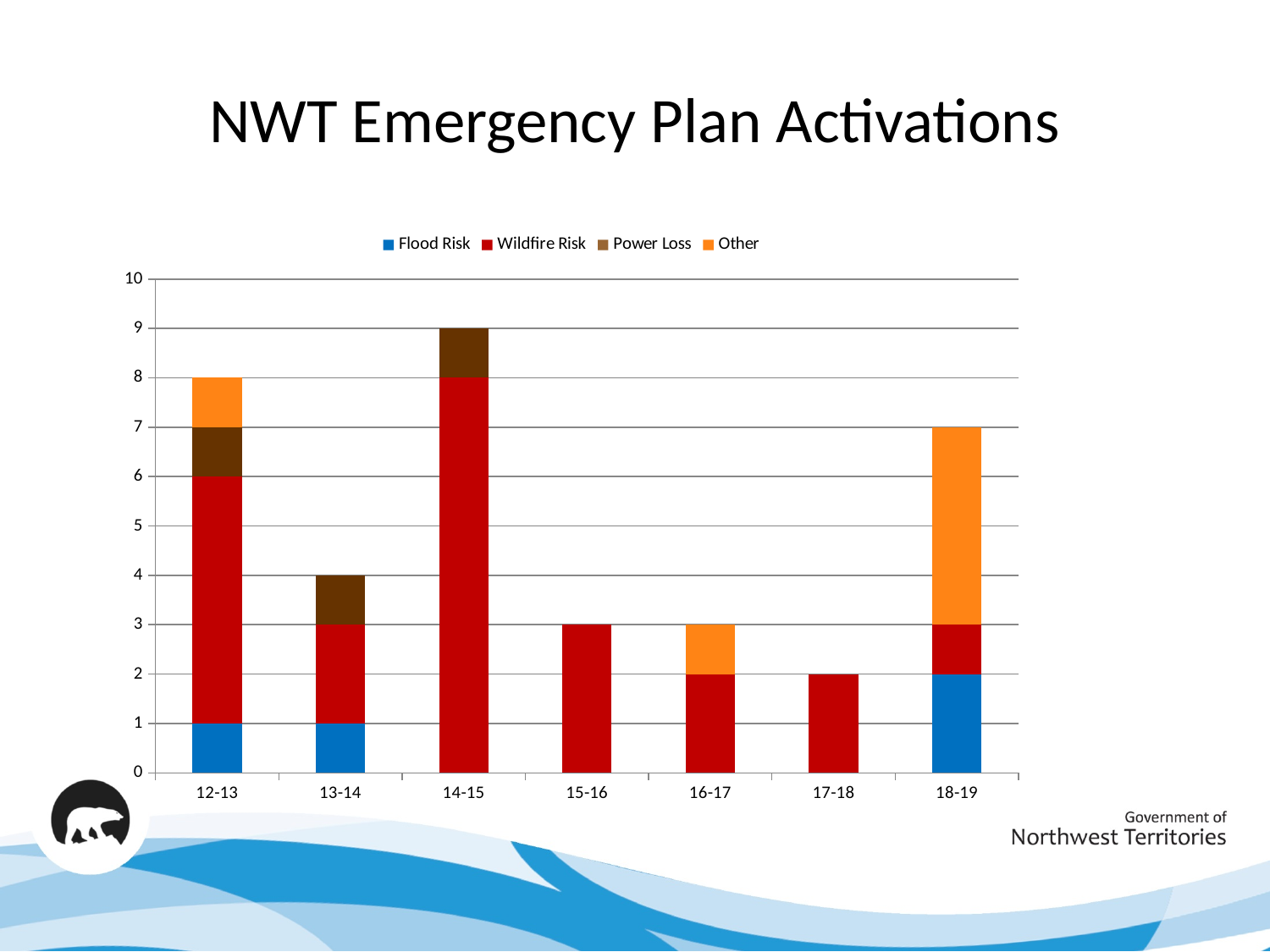
What is the Wildfire Risk value for 15-16? 3 What is the title of the chart? NWT Emergency Plan Activations What is the total height of the stacked bar for 14-15? 9 What is the difference between the total for 14-15 and the total for 13-14? 5 Which year has the highest total number of activations? 14-15 How many series does the legend list? 4 Which has a larger total, 18-19 or 16-17? 18-19 What is the Flood Risk value for 18-19? 2 What is the total height of the stacked bar for 12-13? 8 How many year categories are shown on the x axis? 7 Which year has the lowest total number of activations? 17-18 What kind of chart is shown on the slide? stacked bar chart